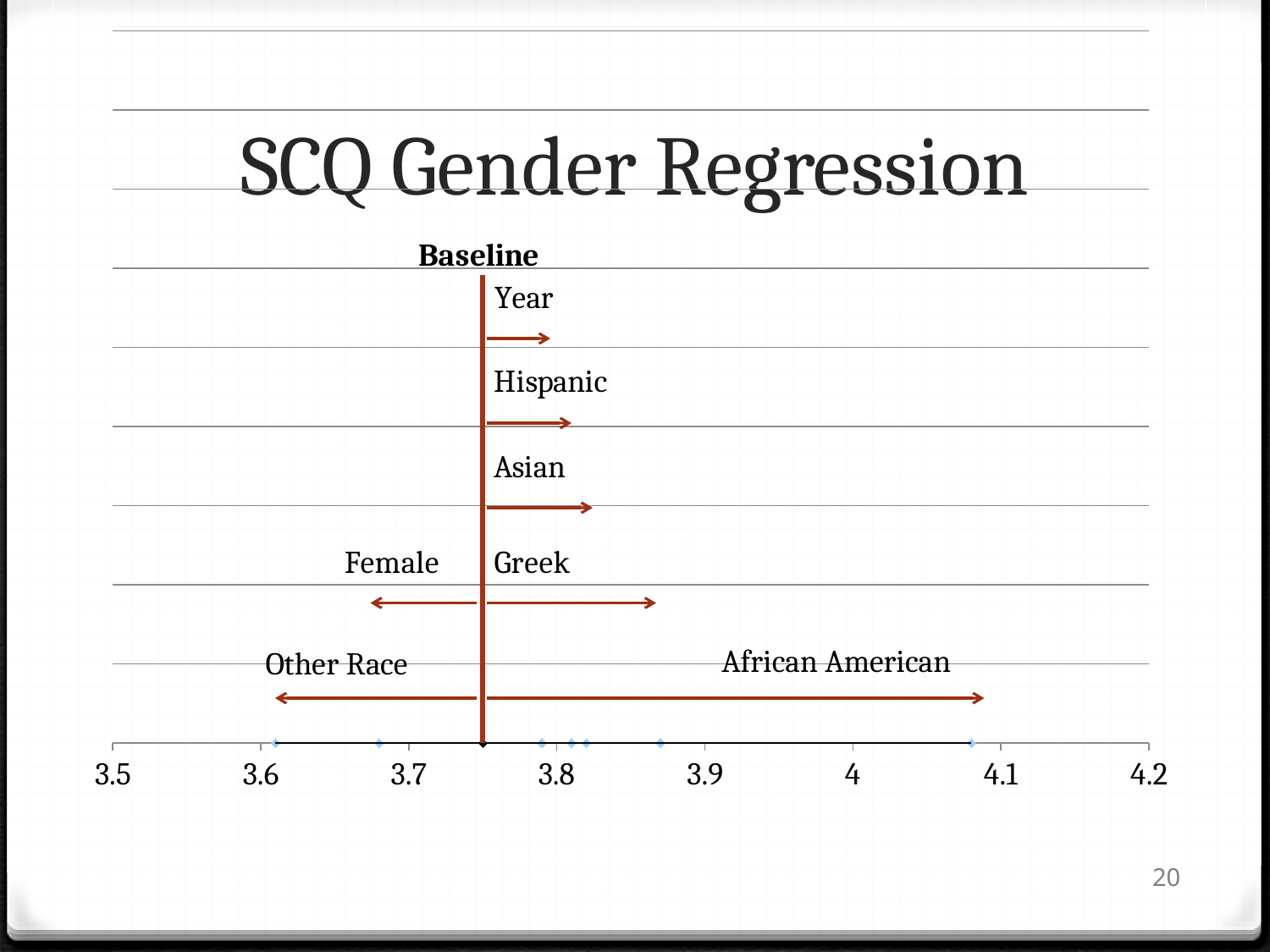
Which is larger, the value for Greek or the value for Year? Greek Which is larger, the value for African American or the value for Greek? African American How many groups are shown with arrows from the baseline? 7 Which group has the highest value (the arrow extending farthest to the right)? African American Which groups have arrows pointing to the left of the baseline? Female and Other Race Which group has the lowest value (the arrow extending farthest to the left)? Other Race Is the value for Other Race greater or less than 3.7? less What is the title of the chart on the slide? SCQ Gender Regression Is the value for Greek greater or less than 3.8? greater Which is larger, the value for Female or the value for Other Race? Female What is the lowest value shown on the x axis? 3.5 Is the value for African American greater or less than 4? greater